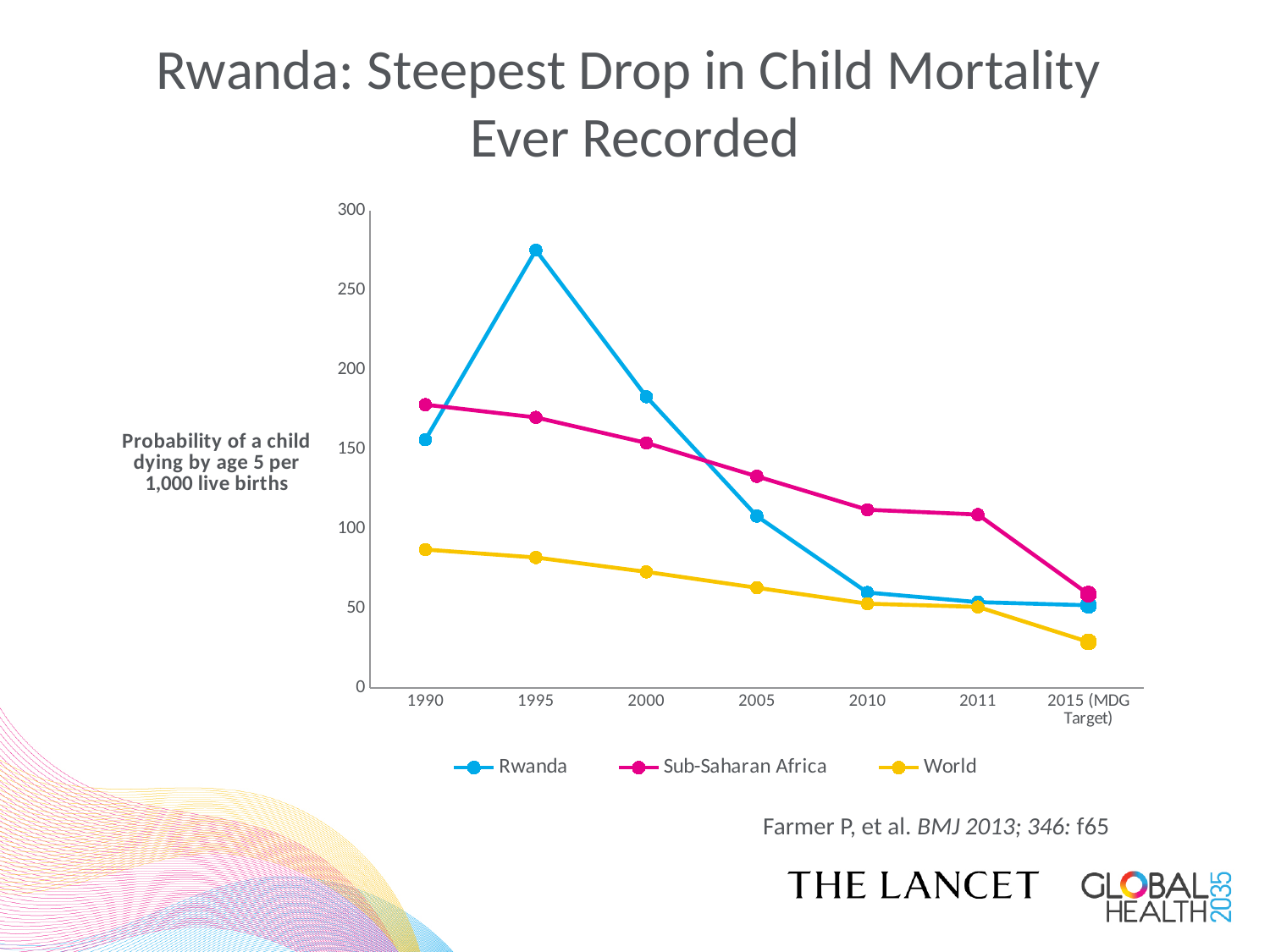
How many series does the legend list? 3 What kind of chart is shown on the slide? line chart Is the value for Sub-Saharan Africa in 1990 greater or less than 200? less In which year does the Rwanda line reach its highest value? 1995 Which is larger in 2010, the value for Rwanda or the value for Sub-Saharan Africa? Sub-Saharan Africa Does the Sub-Saharan Africa line rise or fall from 1990 to 2015 (MDG Target)? fall Is the value for World in 2015 (MDG Target) greater or less than 50? less Is the value for Sub-Saharan Africa in 2005 greater or less than 100? greater How many points along the x axis does each line have? 7 Which series has the lowest value in 1990? World What is the title of the slide's chart? Rwanda: Steepest Drop in Child Mortality Ever Recorded